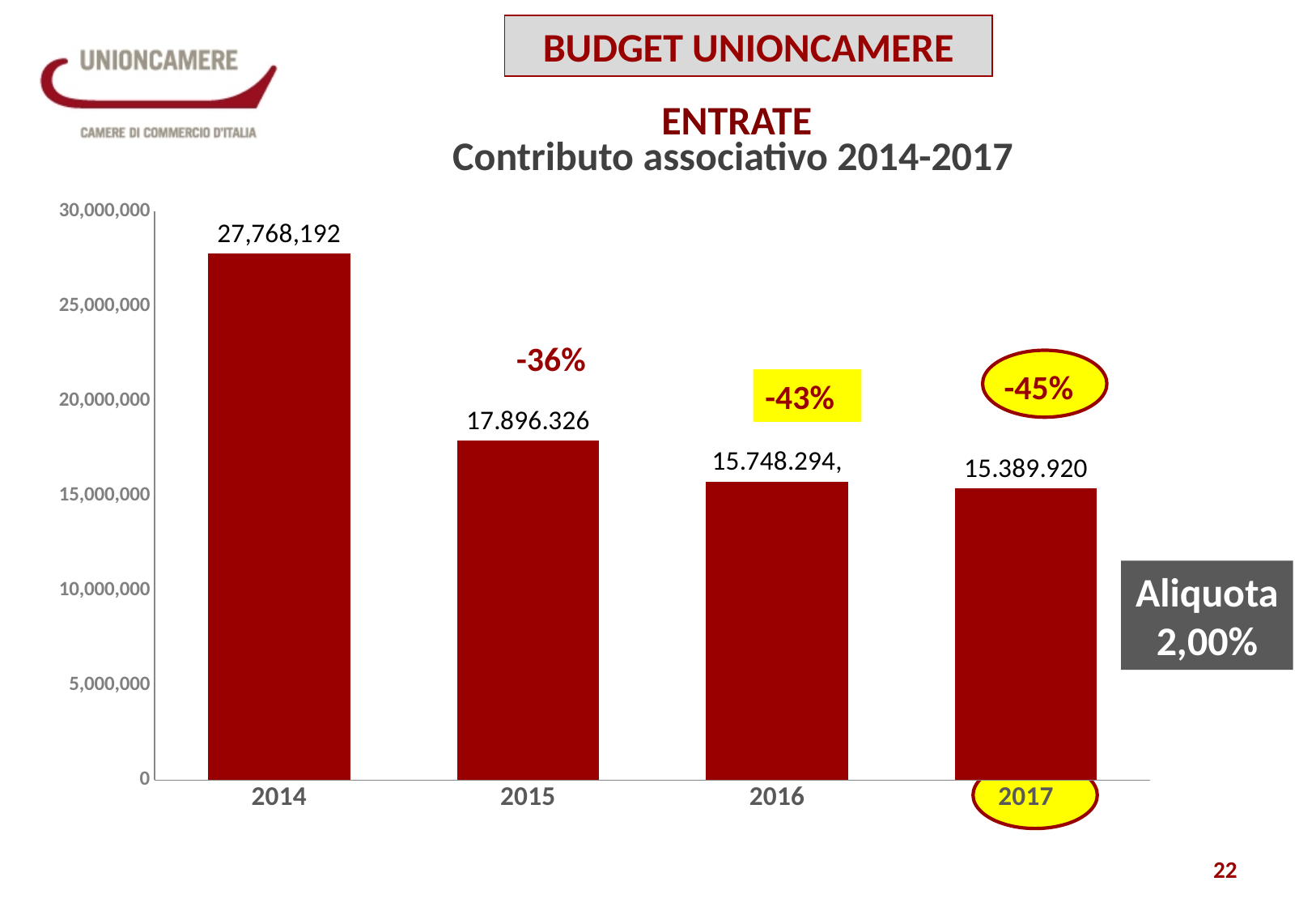
What kind of chart is shown on the slide? bar chart What percentage change is annotated above the 2017 bar? -45% What is the value for 2014? 27,768,192 Is the value for 2014 greater or less than 25,000,000? greater Is the value for 2016 greater or less than 20,000,000? less Which year has the highest value? 2014 What is the value for 2015? 17.896.326 How many years are shown on the x axis? 4 Which year has the lowest value? 2017 Do the values rise or fall from 2014 to 2017? fall Which is larger, the value for 2015 or the value for 2016? 2015 What is the value for 2017? 15.389.920